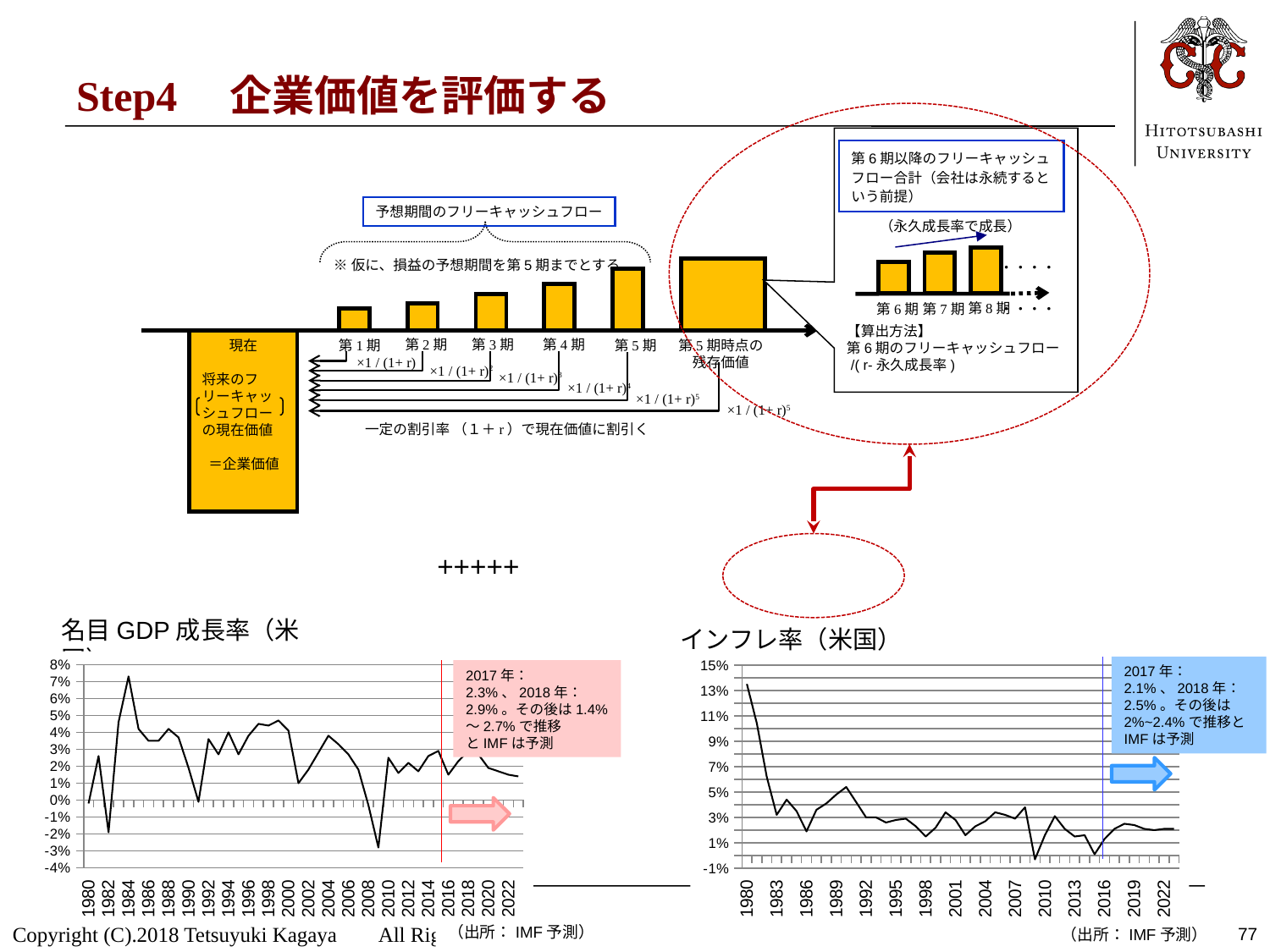
In the インフレ率（米国） chart, in which year is the inflation rate highest? 1980 In the 名目GDP成長率（米国） chart, is the value for 1984 greater or less than 6%? greater What kind of chart is the 名目GDP成長率（米国） chart at the bottom left of the slide? line chart In the 名目GDP成長率（米国） chart, in which year does the line reach its lowest value? 2009 According to the annotation on the 名目GDP成長率（米国） chart, what is the IMF forecast for 2017? 2.3% In the インフレ率（米国） chart, which year has the larger value, 1980 or 1992? 1980 According to the annotation on the インフレ率（米国） chart, what is the IMF forecast for 2018? 2.5% What kind of chart is the インフレ率（米国） chart at the bottom right of the slide? line chart In the インフレ率（米国） chart, is the value for 1980 greater or less than 12%? greater In the 名目GDP成長率（米国） chart, is the value for 2009 greater or less than -2%? less In the 名目GDP成長率（米国） chart, in which year does the line reach its highest value? 1984 In the インフレ率（米国） chart, does the inflation rate generally rise or fall from 1980 to 2022? fall